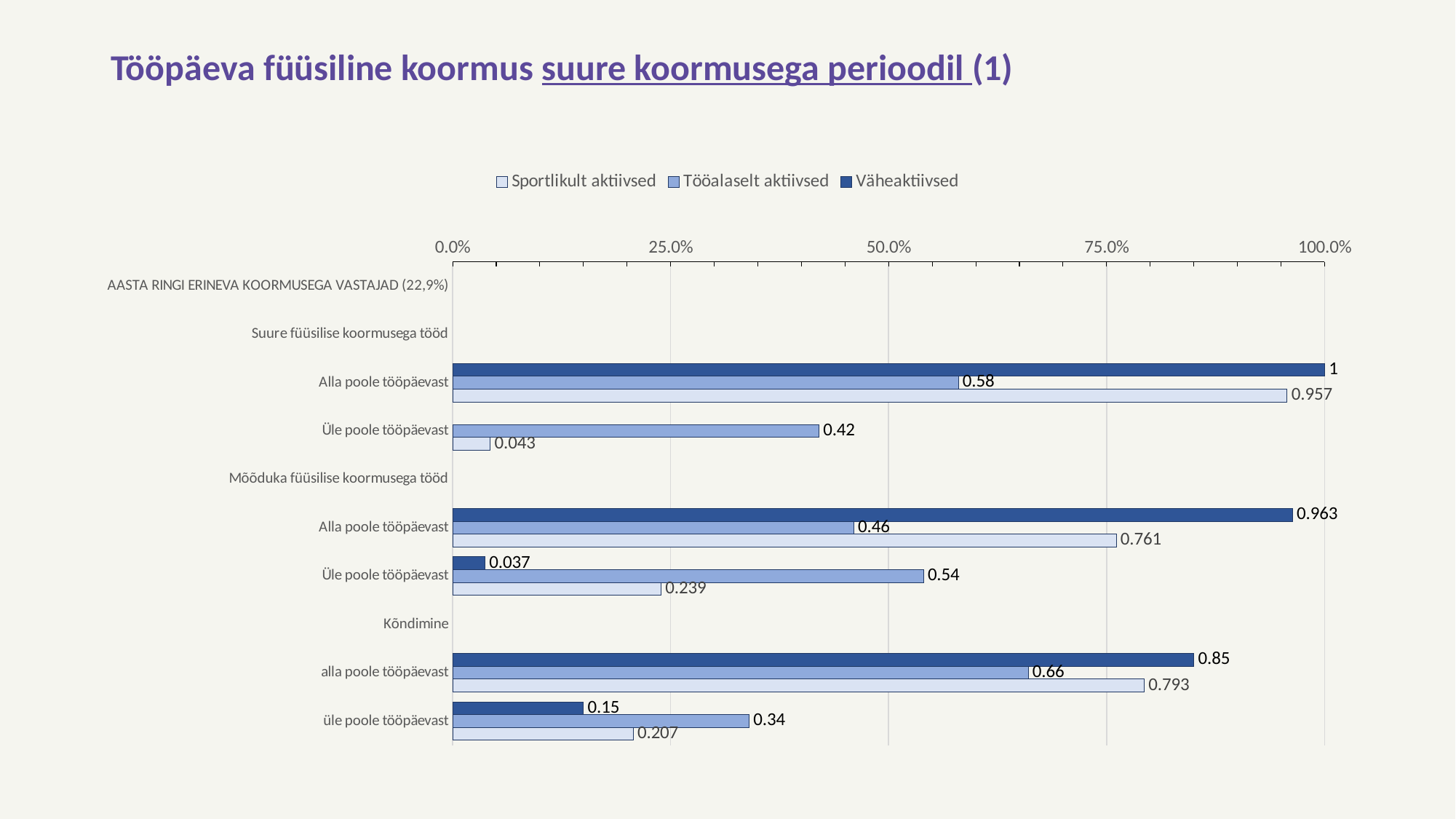
Which series has the lowest value for 'Üle poole tööpäevast' under 'Mõõduka füüsilise koormusega tööd'? Väheaktiivsed Is the Tööalaselt aktiivsed value for 'Üle poole tööpäevast' under 'Mõõduka füüsilise koormusega tööd' greater or less than 50.0%? greater What is the value for Sportlikult aktiivsed for 'Alla poole tööpäevast' under 'Mõõduka füüsilise koormusega tööd'? 0.761 What is the value for Tööalaselt aktiivsed for 'Üle poole tööpäevast' under 'Suure füüsilise koormusega tööd'? 0.42 Which is larger for 'Alla poole tööpäevast' under 'Mõõduka füüsilise koormusega tööd': Väheaktiivsed or Sportlikult aktiivsed? Väheaktiivsed How many series does the legend list? 3 What is the difference between the Sportlikult aktiivsed and Tööalaselt aktiivsed values for 'üle poole tööpäevast' under 'Kõndimine'? 0.133 What is the value for Väheaktiivsed for 'Alla poole tööpäevast' under 'Suure füüsilise koormusega tööd'? 1 Which legend entry is shown with the darkest blue colour? Väheaktiivsed What kind of chart is shown on the slide? bar chart Which series has the highest value for 'alla poole tööpäevast' under 'Kõndimine'? Väheaktiivsed What is the value for Väheaktiivsed for 'üle poole tööpäevast' under 'Kõndimine'? 0.15